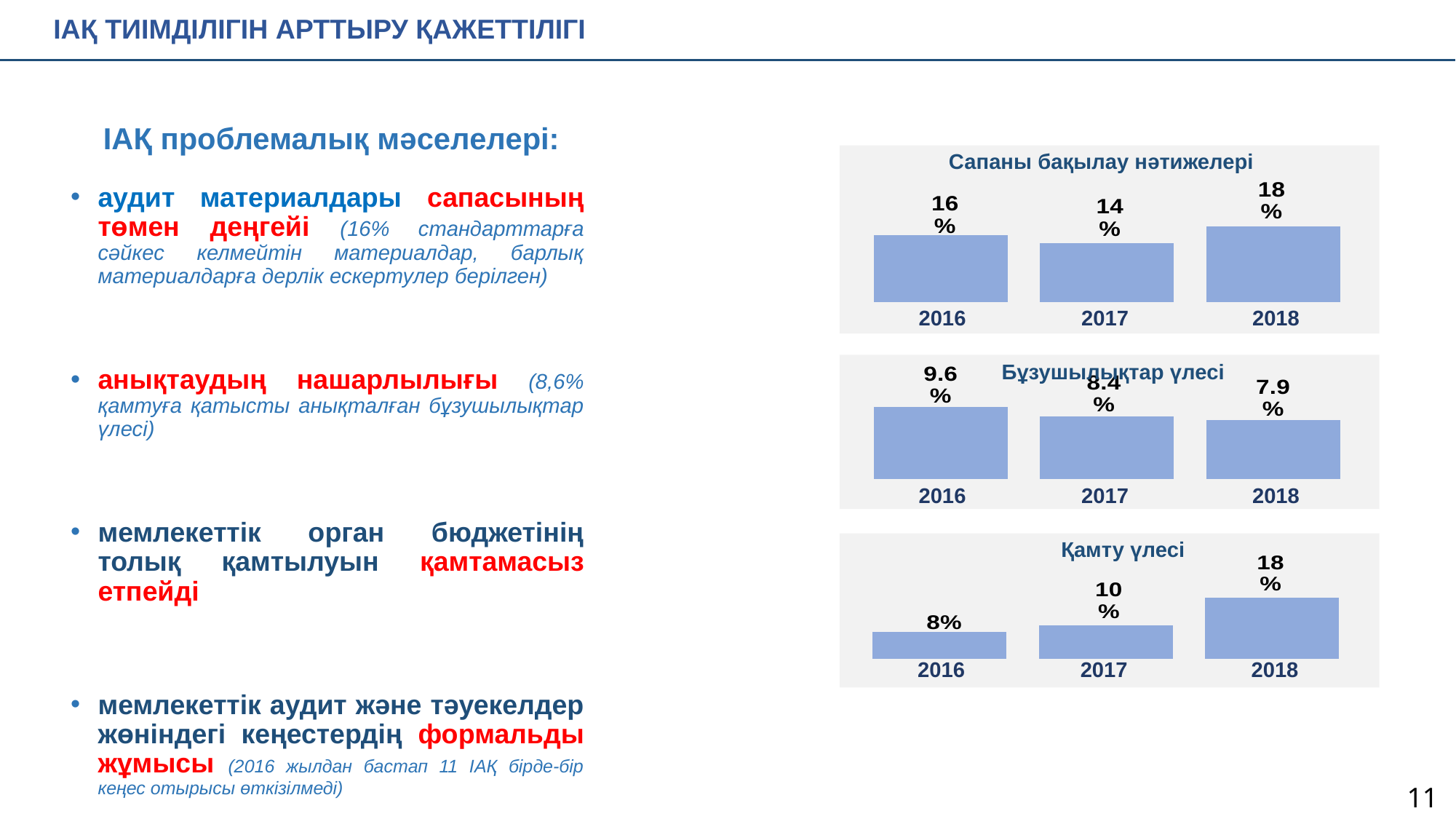
In the chart titled "Қамту үлесі", what is the value for 2018? 18% In the chart titled "Қамту үлесі", which is larger, the value for 2016 or the value for 2017? 2017 In the chart titled "Бұзушылықтар үлесі", do the values rise or fall from 2016 to 2018? fall In the chart titled "Сапаны бақылау нәтижелері", what is the value for 2016? 16% In the chart titled "Қамту үлесі", do the values rise or fall from 2016 to 2018? rise In the chart titled "Сапаны бақылау нәтижелері", which year has the highest value? 2018 How many years are shown in the chart titled "Сапаны бақылау нәтижелері"? 3 In the chart titled "Бұзушылықтар үлесі", what is the value for 2017? 8.4% What kind of chart is the chart titled "Қамту үлесі"? bar chart In the chart titled "Сапаны бақылау нәтижелері", which year has the lowest value? 2017 In the chart titled "Қамту үлесі", what is the difference between the 2018 and 2016 values? 10% In the chart titled "Бұзушылықтар үлесі", what is the difference between the 2016 and 2018 values? 1.7%